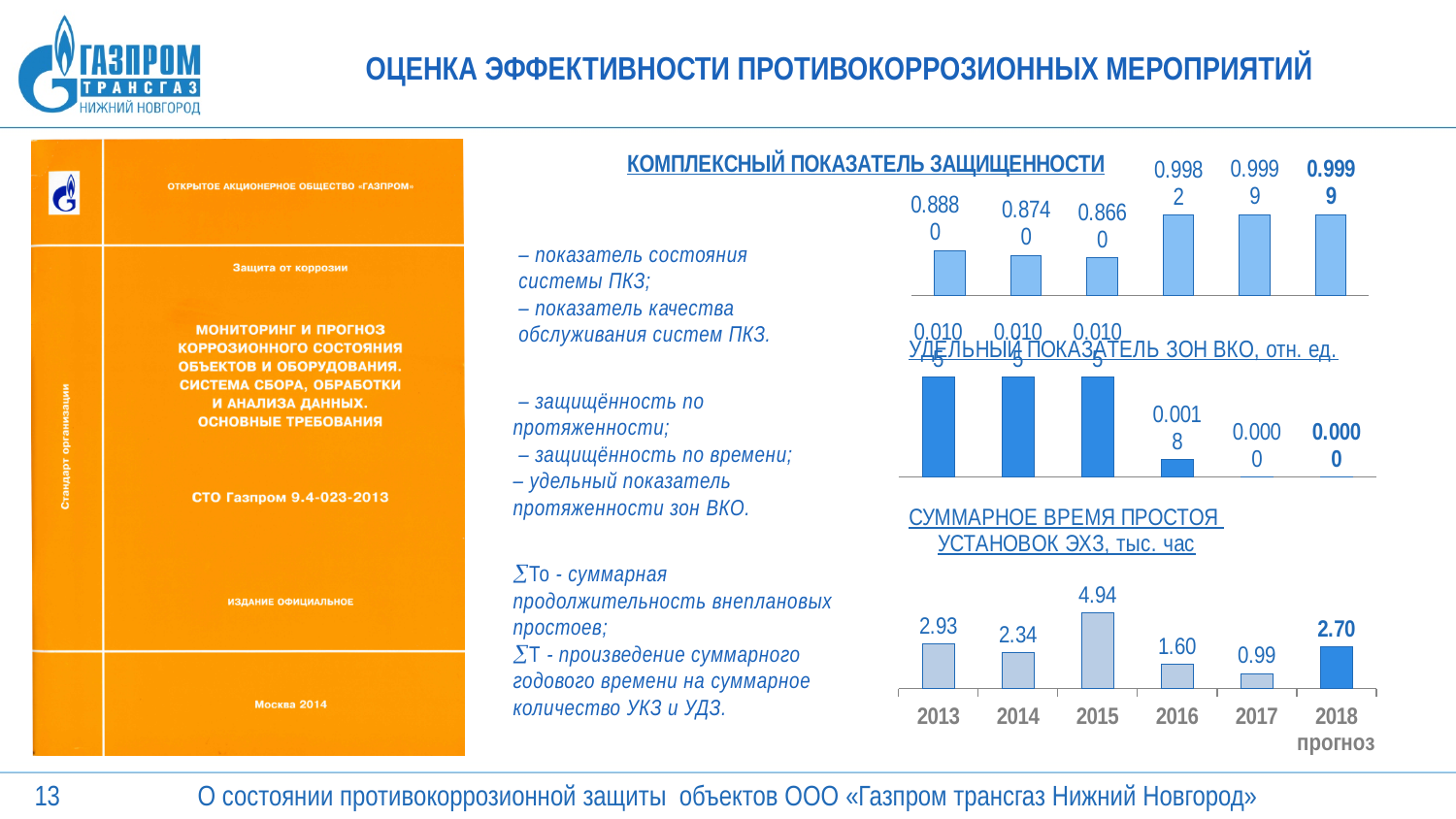
What unit is given in the title of the bottom chart on the slide? тыс. час In the chart 'СУММАРНОЕ ВРЕМЯ ПРОСТОЯ УСТАНОВОК ЭХЗ, тыс. час', which year has the highest value? 2015 In the chart 'КОМПЛЕКСНЫЙ ПОКАЗАТЕЛЬ ЗАЩИЩЕННОСТИ', what is the value of the first (leftmost) bar? 0.8880 In the chart 'УДЕЛЬНЫЙ ПОКАЗАТЕЛЬ ЗОН ВКО, отн. ед.', what is the value of the fourth bar? 0.0018 In the chart 'СУММАРНОЕ ВРЕМЯ ПРОСТОЯ УСТАНОВОК ЭХЗ, тыс. час', which is larger: the value for 2016 or the value for 2018 прогноз? 2018 прогноз In the chart 'СУММАРНОЕ ВРЕМЯ ПРОСТОЯ УСТАНОВОК ЭХЗ, тыс. час', what is the value for 2015? 4.94 In the chart 'КОМПЛЕКСНЫЙ ПОКАЗАТЕЛЬ ЗАЩИЩЕННОСТИ', do the values rise or fall from the third bar to the sixth bar? rise In the chart 'СУММАРНОЕ ВРЕМЯ ПРОСТОЯ УСТАНОВОК ЭХЗ, тыс. час', what is the difference between the values for 2013 and 2014? 0.59 What type of chart is 'СУММАРНОЕ ВРЕМЯ ПРОСТОЯ УСТАНОВОК ЭХЗ, тыс. час'? bar chart How many bars are shown in the chart 'СУММАРНОЕ ВРЕМЯ ПРОСТОЯ УСТАНОВОК ЭХЗ, тыс. час'? 6 In the chart 'КОМПЛЕКСНЫЙ ПОКАЗАТЕЛЬ ЗАЩИЩЕННОСТИ', which bar has the lowest value? the third bar (0.8660) In the chart 'СУММАРНОЕ ВРЕМЯ ПРОСТОЯ УСТАНОВОК ЭХЗ, тыс. час', which year has the lowest value? 2017